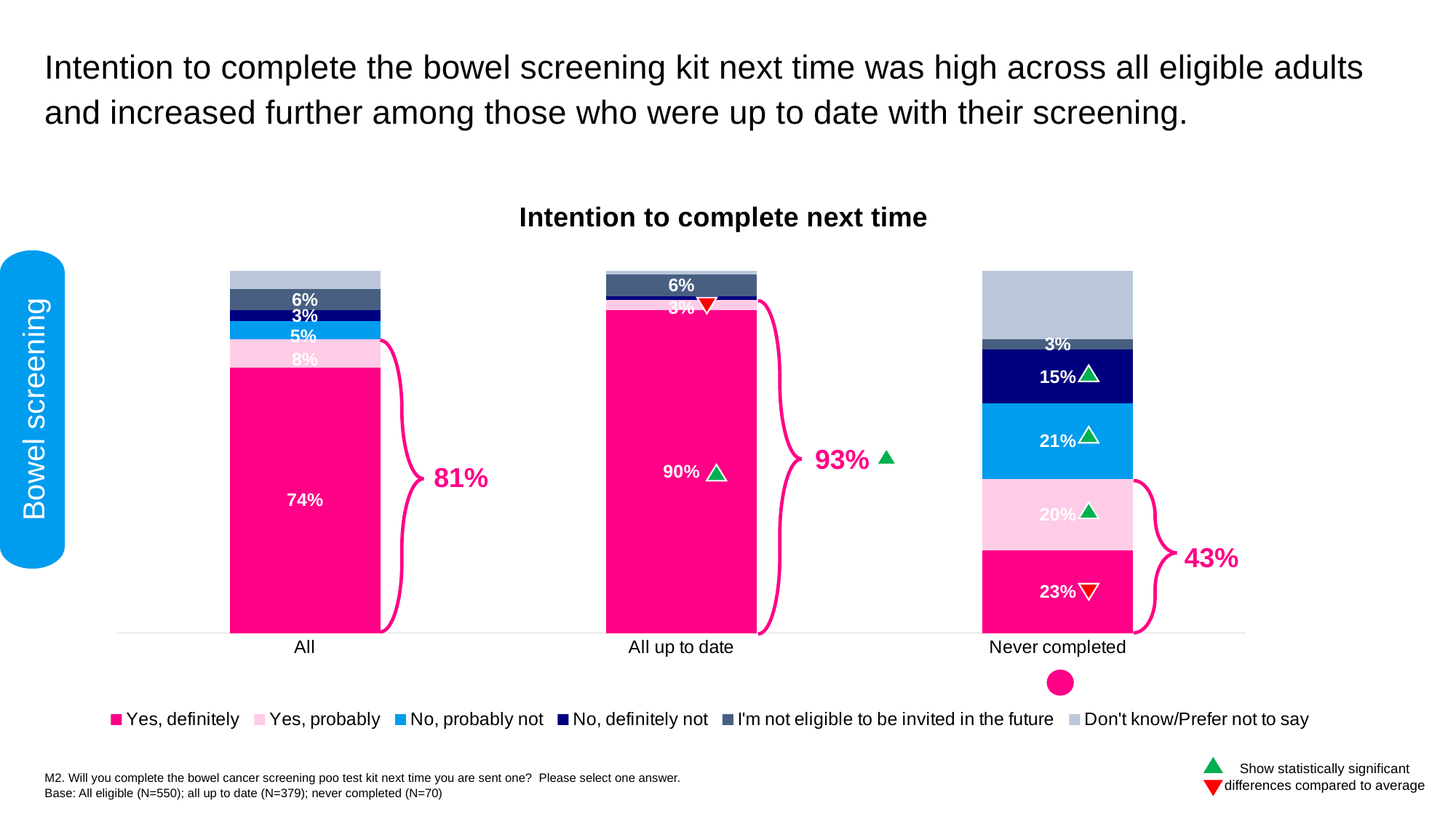
What is the value for 'No, probably not' in the 'Never completed' bar? 21% What is the value for 'Yes, definitely' in the 'Never completed' bar? 23% What is the difference between the 'Yes, definitely' values for 'All up to date' and 'All'? 16% What kind of chart is shown on the slide? Stacked bar chart How many series does the legend list? 6 Which group has the lowest 'Yes, definitely' value? Never completed How many groups (bars) are shown on the x axis? 3 Which group has the highest 'Yes, definitely' value? All up to date What is the value for 'No, definitely not' in the 'Never completed' bar? 15% What is the value for 'Yes, definitely' in the 'All' bar? 74% What is the value for 'Yes, definitely' in the 'All up to date' bar? 90% Which is larger in the 'Never completed' bar: 'Yes, probably' or 'No, definitely not'? Yes, probably